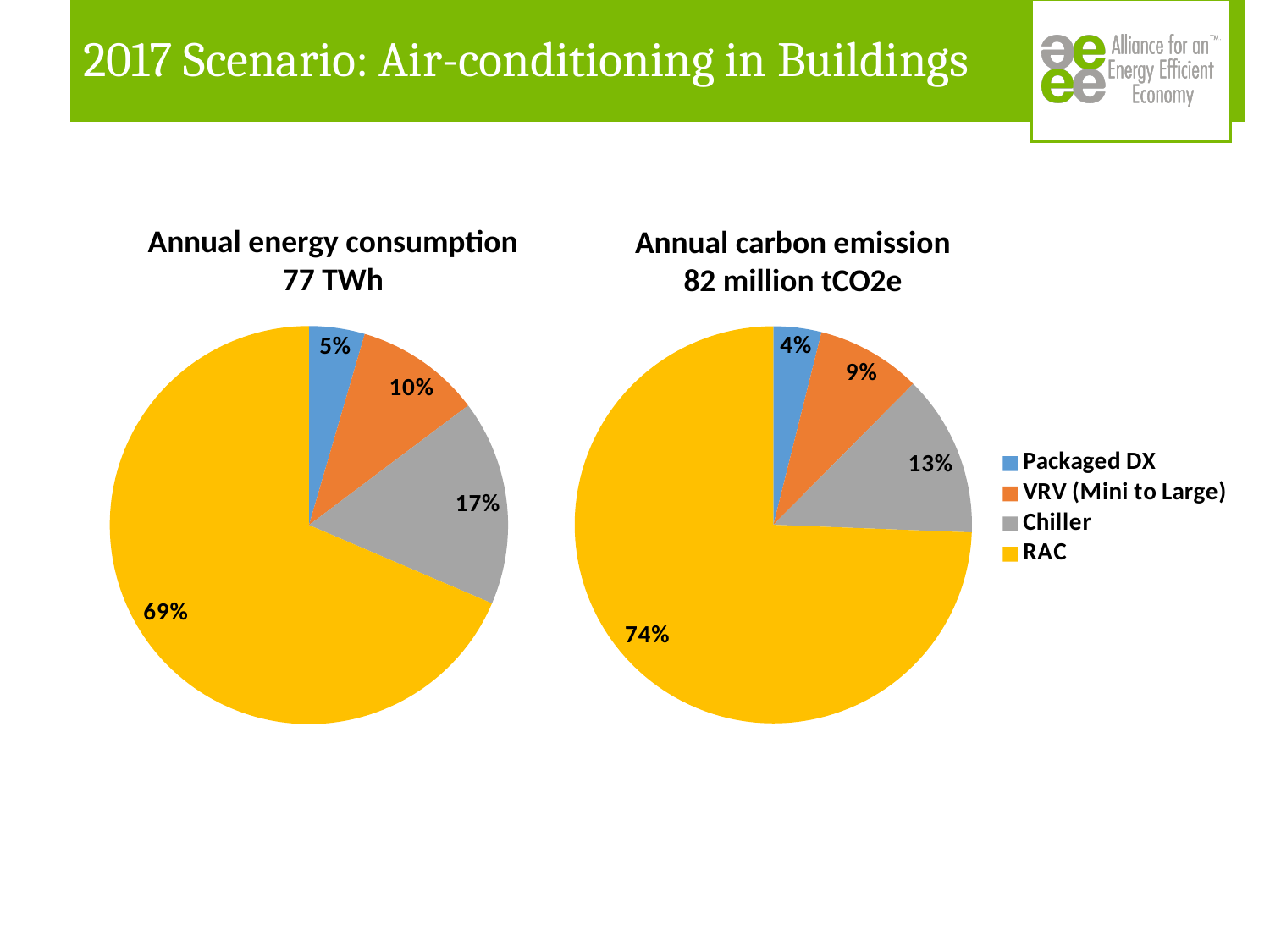
In the 'Annual carbon emission 82 million tCO2e' chart, what share does Chiller have? 13% In the 'Annual energy consumption 77 TWh' chart, what share does RAC have? 69% In the 'Annual energy consumption 77 TWh' chart, which is larger: the Chiller share or the Packaged DX share? Chiller In the 'Annual carbon emission 82 million tCO2e' chart, which category has the smallest slice? Packaged DX In the 'Annual energy consumption 77 TWh' chart, what is the value for Packaged DX? 5% In the 'Annual carbon emission 82 million tCO2e' chart, what is the value for VRV (Mini to Large)? 9% In the 'Annual energy consumption 77 TWh' chart, what is the difference between the Chiller share and the VRV (Mini to Large) share? 7% What colour represents Chiller in the legend? Grey In the 'Annual carbon emission 82 million tCO2e' chart, what is the difference between the RAC share and the Chiller share? 61% What kind of chart is the 'Annual carbon emission 82 million tCO2e' chart? Pie chart In the 'Annual energy consumption 77 TWh' chart, which category has the largest slice? RAC How many categories does the legend list? 4